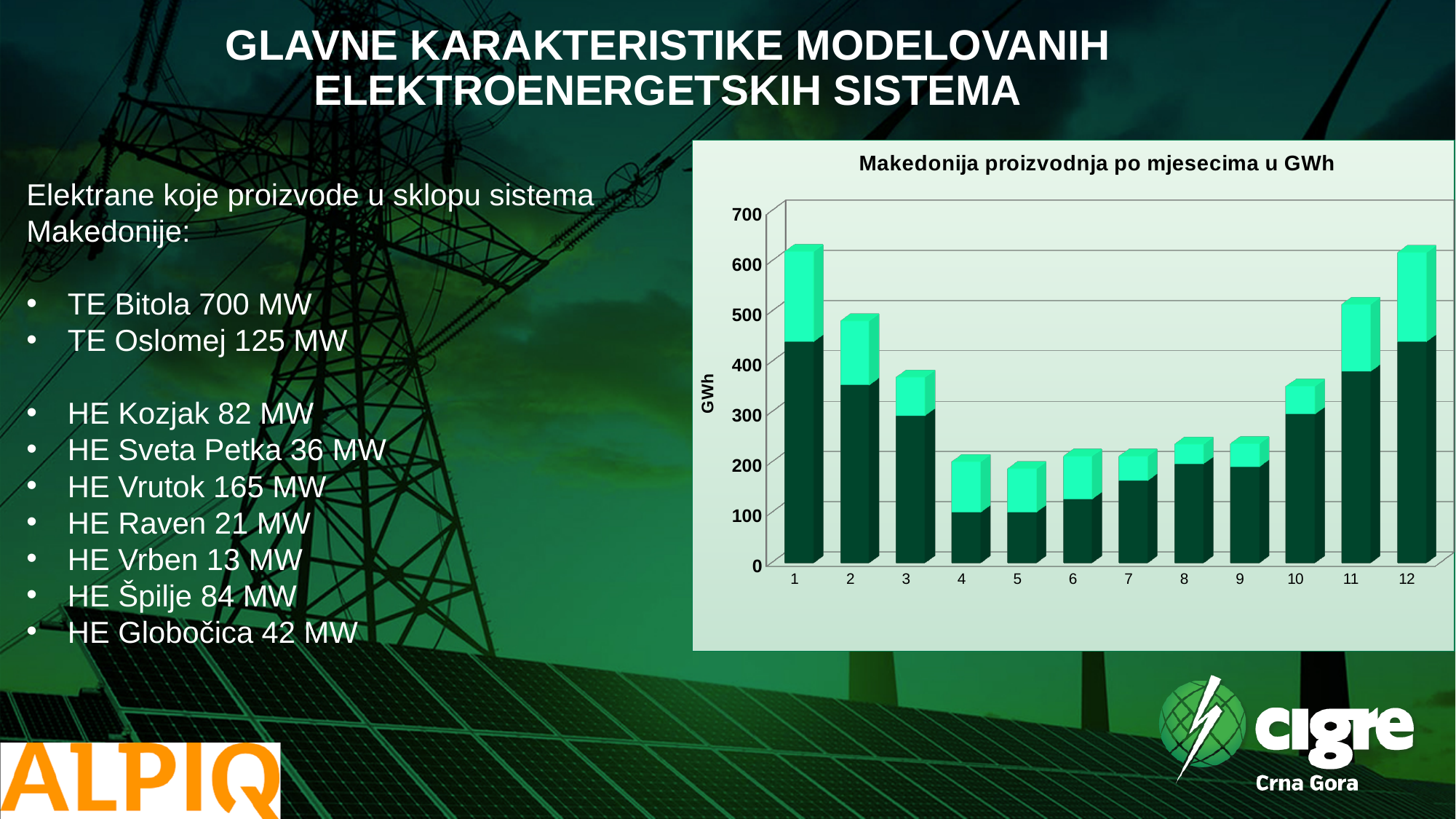
What is the title of the chart? Makedonija proizvodnja po mjesecima u GWh Do the total values rise or fall from month 7 to month 12? rise Is the total value for month 2 greater or less than 400? greater What is the label on the vertical axis of the chart? GWh Is the total value for month 5 greater or less than 300? less Is the total value for month 11 greater or less than 400? greater Which month has the larger total value, month 2 or month 3? month 2 What type of chart is shown on the slide? bar chart How many months (categories) are plotted on the x axis? 12 Which month has the larger total value, month 6 or month 10? month 10